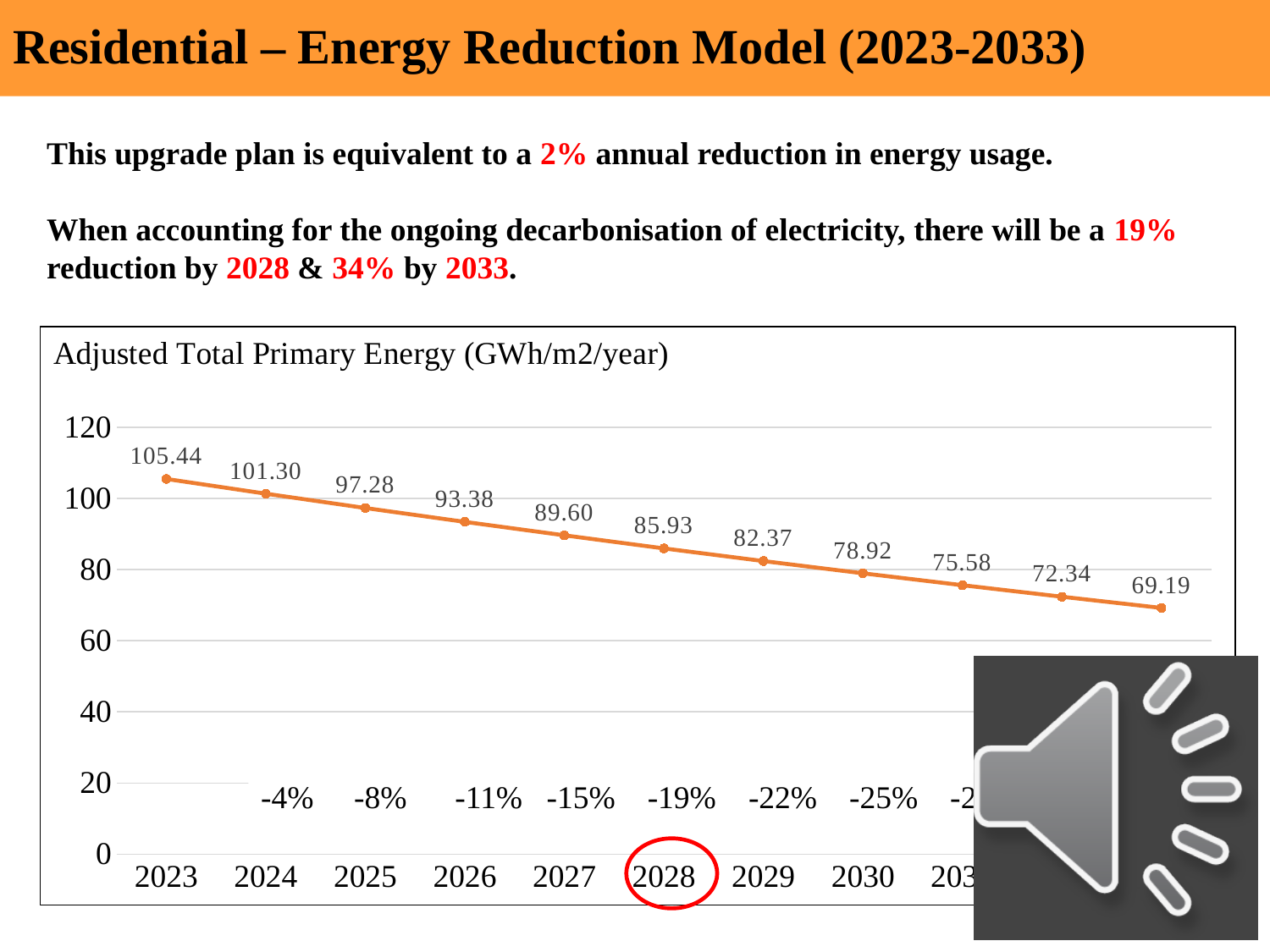
Is the value for 2029 greater or less than 80? greater Which year has the larger value, 2025 or 2027? 2025 What kind of chart is shown on the slide? line chart What is the difference between the 2024 value and the 2025 value? 4.02 What is the Adjusted Total Primary Energy value for 2023? 105.44 How many data points are plotted on the line? 11 What percentage reduction label is shown for 2028? -19% What is the Adjusted Total Primary Energy value for 2030? 78.92 What is the Adjusted Total Primary Energy value for 2028? 85.93 What is the difference between the 2023 value and the 2028 value? 19.51 Which year has the highest Adjusted Total Primary Energy value? 2023 What is the lowest value plotted on the line? 69.19